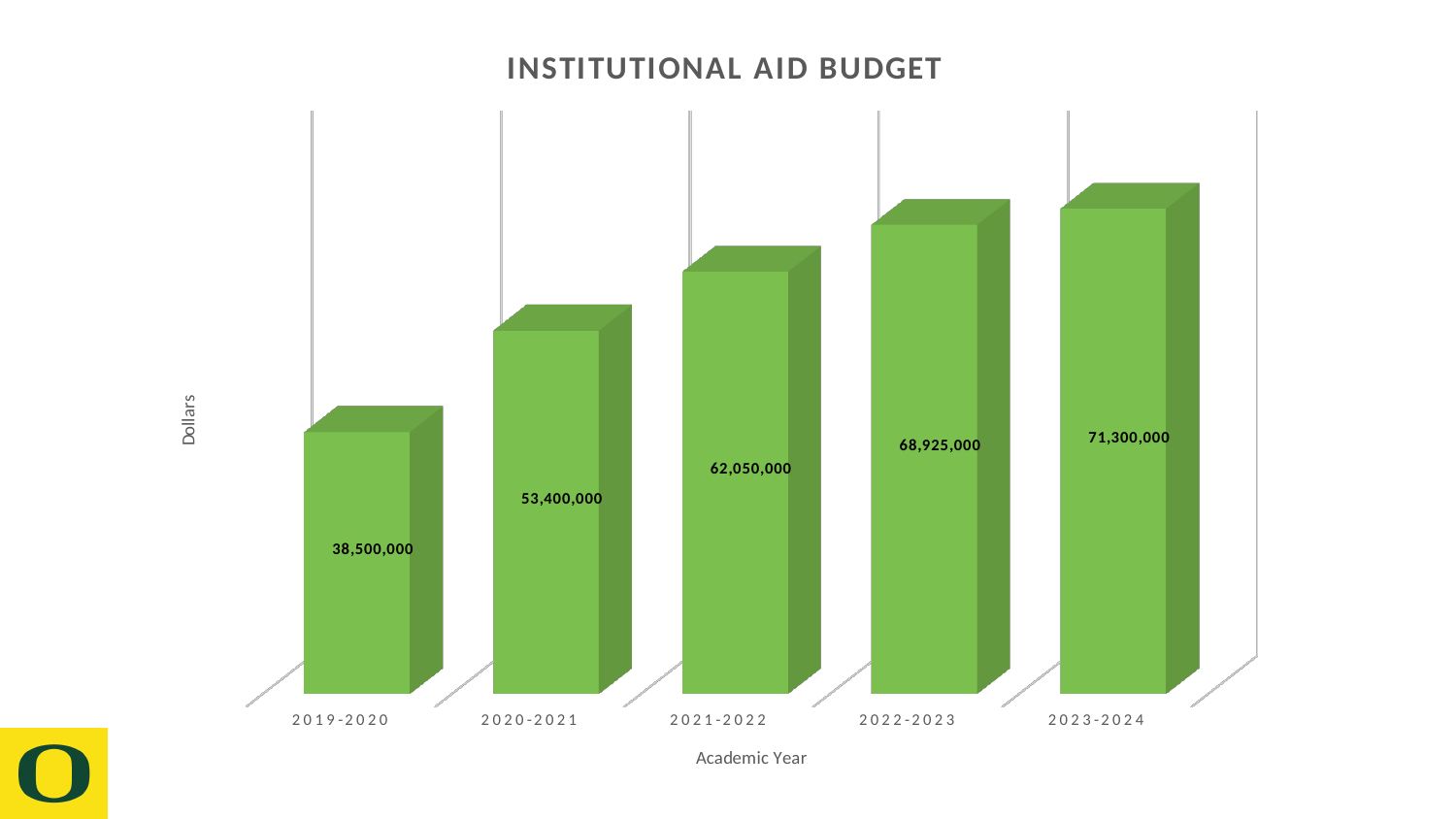
Which academic year has the highest institutional aid budget? 2023-2024 What is the institutional aid budget for 2019-2020? 38,500,000 Which is larger, the budget for 2021-2022 or the budget for 2022-2023? 2022-2023 Does the institutional aid budget rise or fall from 2019-2020 to 2023-2024? Rise What is the institutional aid budget for 2021-2022? 62,050,000 What is the difference between the 2020-2021 and 2019-2020 institutional aid budgets? 14,900,000 What is the title of the chart? INSTITUTIONAL AID BUDGET What kind of chart is shown on the slide? Bar chart Which academic year has the lowest institutional aid budget? 2019-2020 What is the difference between the 2023-2024 and 2022-2023 institutional aid budgets? 2,375,000 How many academic years are shown in the chart? 5 What is the institutional aid budget for 2023-2024? 71,300,000